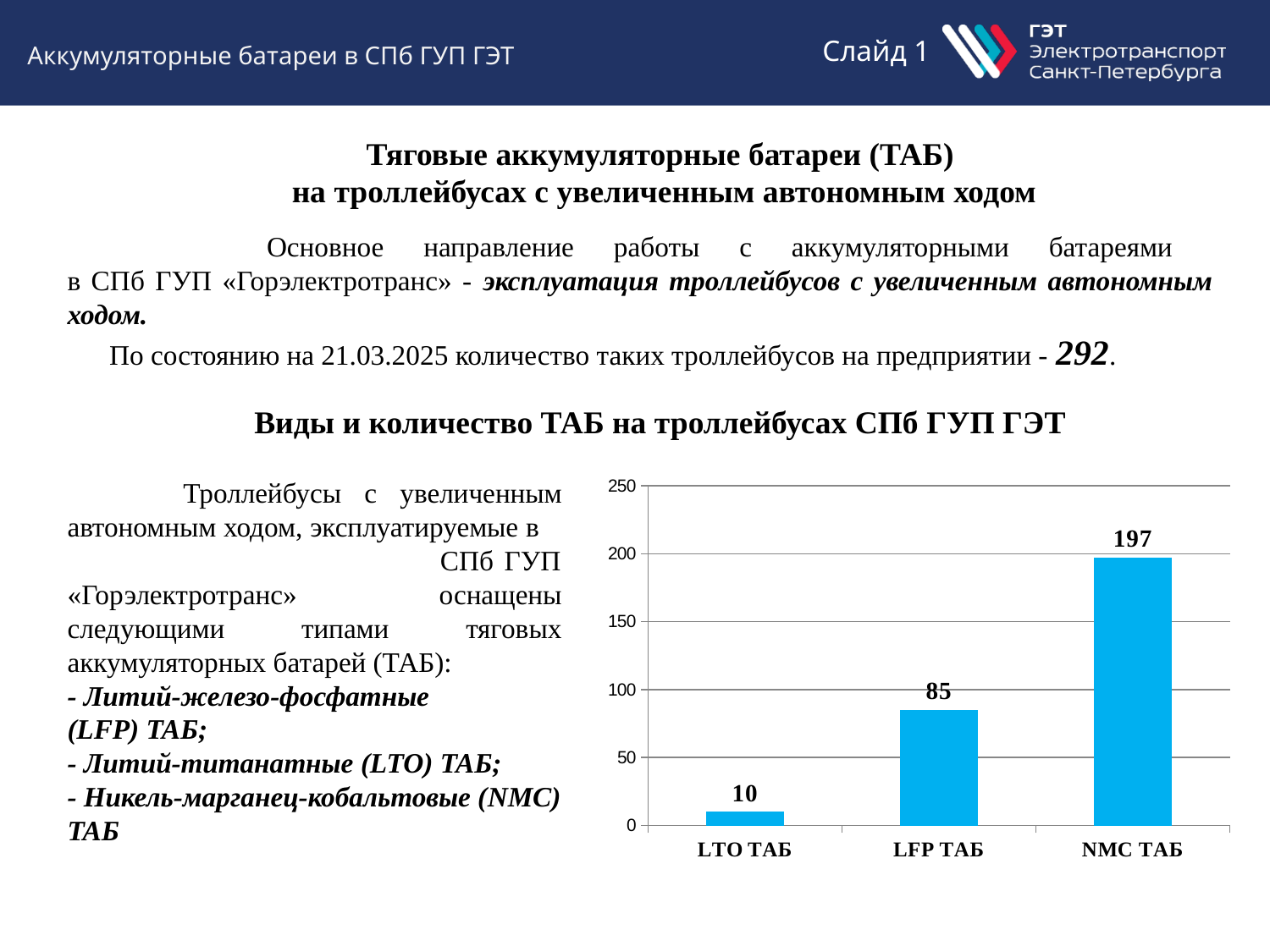
Do the values rise or fall from left to right along the x axis? rise How many categories are shown on the chart? 3 What kind of chart is shown on the slide? bar chart What is the value for LTO ТАБ? 10 Which is larger, the value for LFP ТАБ or the value for LTO ТАБ? LFP ТАБ Which category has the highest value? NMC ТАБ Which category has the lowest value? LTO ТАБ What is the value for NMC ТАБ? 197 What is the difference between the values for NMC ТАБ and LFP ТАБ? 112 What is the value for LFP ТАБ? 85 What is the difference between the values for LFP ТАБ and LTO ТАБ? 75 Is the value for NMC ТАБ greater or less than 150? greater